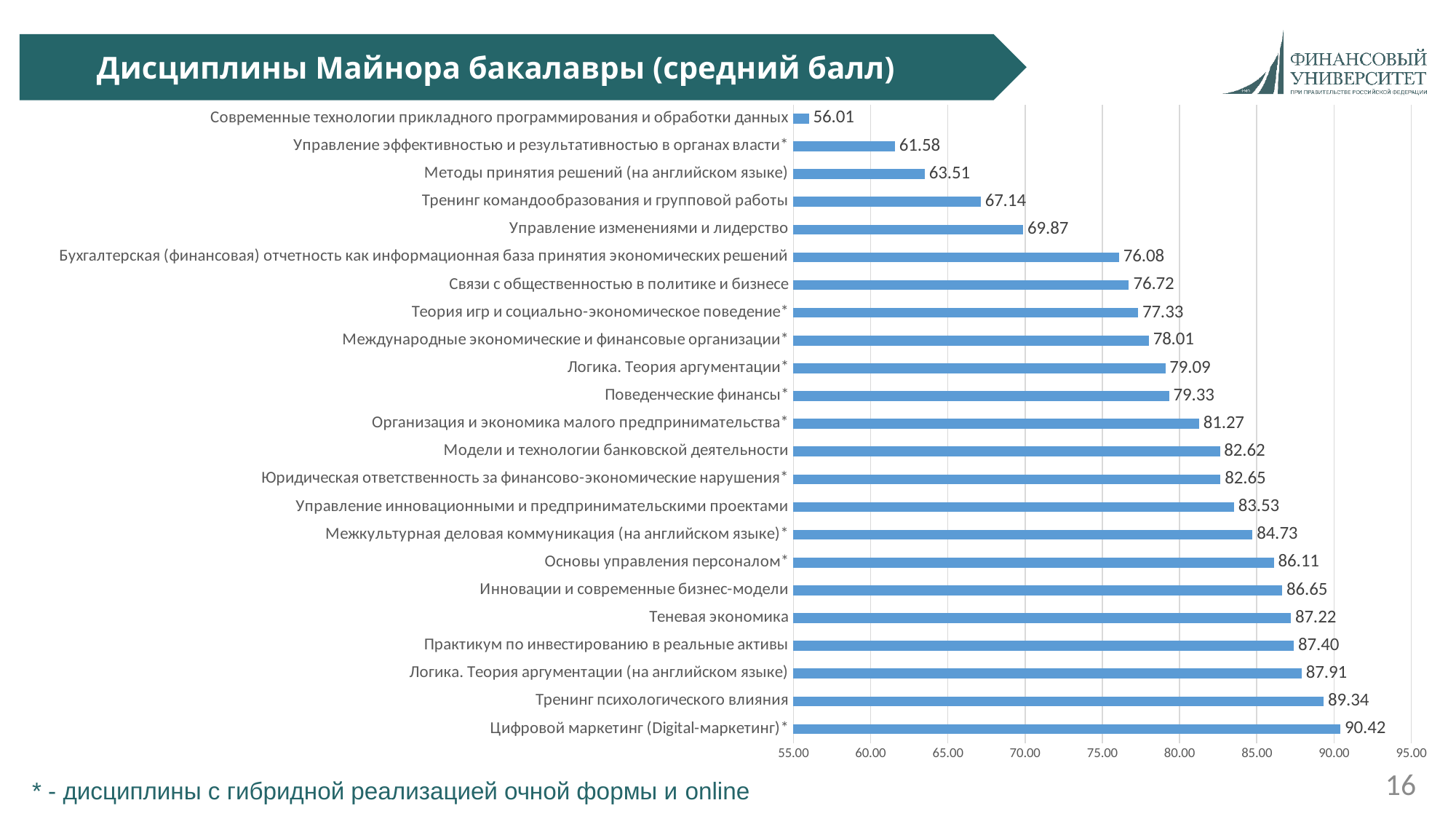
What is the average score for Управление изменениями и лидерство? 69.87 What is the maximum value shown on the horizontal axis? 95.00 Which discipline has the highest average score? Цифровой маркетинг (Digital-маркетинг)* Is the value for Связи с общественностью в политике и бизнесе greater or less than 75.00? greater What kind of chart is shown on the slide? bar chart What is the average score for Теневая экономика? 87.22 What is the title of the chart on the slide? Дисциплины Майнора бакалавры (средний балл) What is the average score for Поведенческие финансы*? 79.33 How many disciplines are shown in the chart? 23 What is the difference between the average scores of Тренинг психологического влияния and Тренинг командообразования и групповой работы? 22.20 Which has a higher average score: Основы управления персоналом* or Межкультурная деловая коммуникация (на английском языке)*? Основы управления персоналом* Which discipline has the lowest average score? Современные технологии прикладного программирования и обработки данных